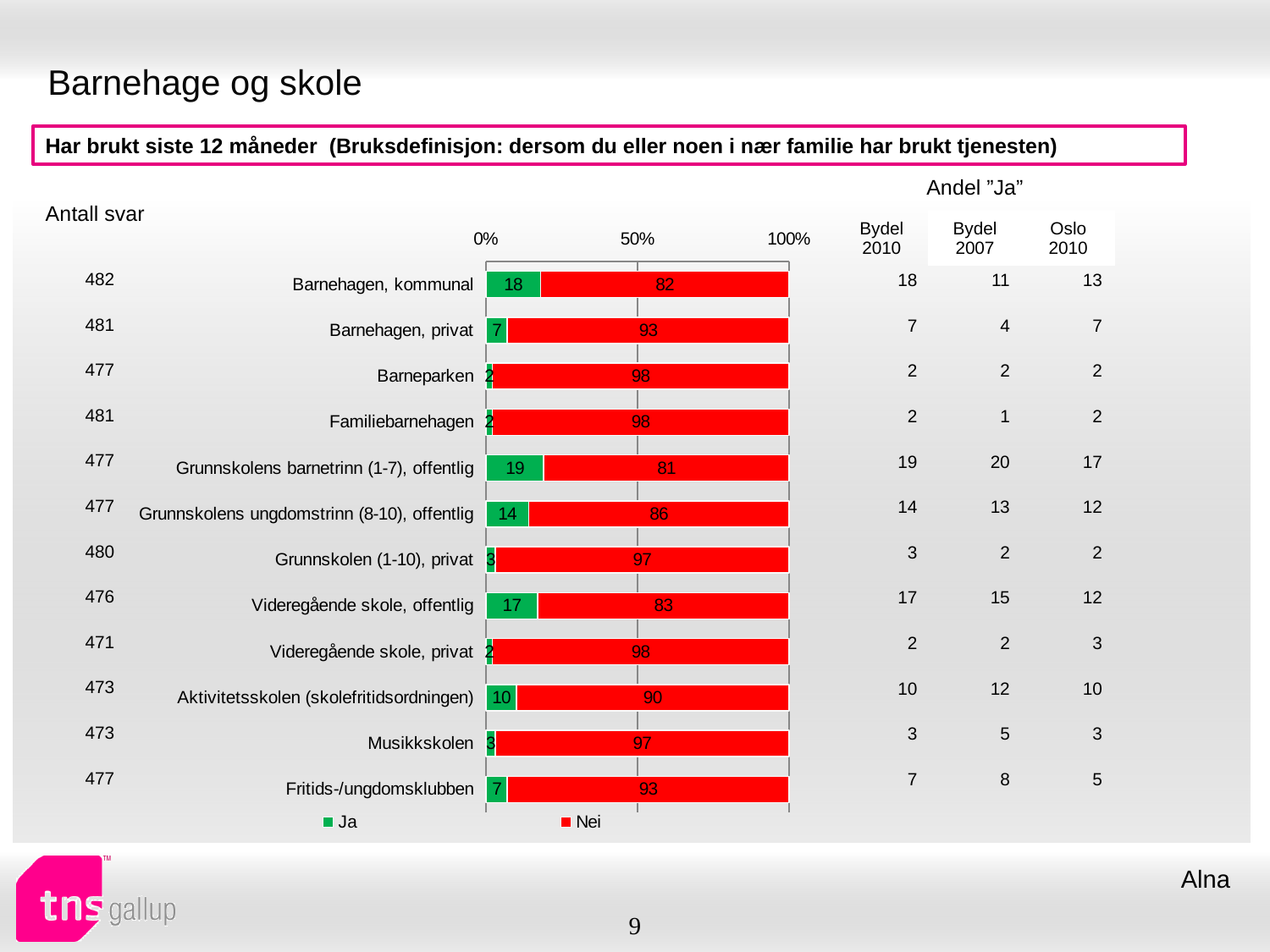
What is the "Nei" value for Aktivitetsskolen (skolefritidsordningen)? 90 Which has a larger "Ja" value: Grunnskolens ungdomstrinn (8-10), offentlig or Fritids-/ungdomsklubben? Grunnskolens ungdomstrinn (8-10), offentlig Which category has the lowest "Nei" value? Grunnskolens barnetrinn (1-7), offentlig What is the total of the stacked bar for Musikkskolen? 100 What type of chart is shown on the slide? Stacked bar chart How many series does the chart legend list? 2 How many categories are plotted in the chart? 12 What is the "Ja" value for Barnehagen, kommunal? 18 Which category has the highest "Ja" value? Grunnskolens barnetrinn (1-7), offentlig What is the "Ja" value for Videregående skole, offentlig? 17 What is the difference between the "Nei" values for Barnehagen, privat and Barnehagen, kommunal? 11 What are the two legend entries of the chart? Ja and Nei